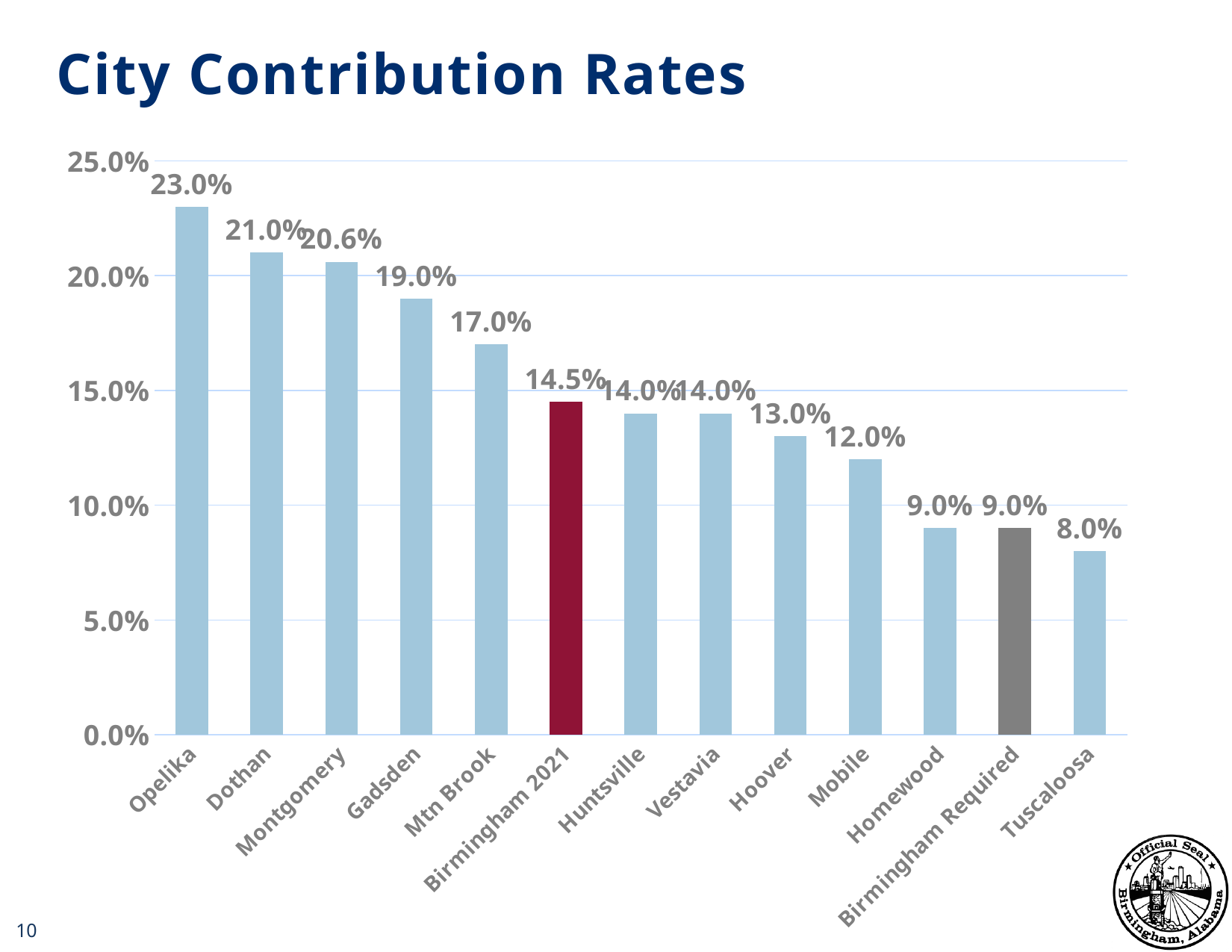
How many cities or categories are shown on the chart? 13 What kind of chart is shown on the slide? Bar chart What is the city contribution rate for Opelika? 23.0% What is the city contribution rate for Birmingham 2021? 14.5% Which city has the lowest contribution rate? Tuscaloosa Do the contribution rates rise or fall from left to right across the chart? Fall Which has a higher contribution rate, Gadsden or Mtn Brook? Gadsden Which city has the highest contribution rate? Opelika What is the difference between the Birmingham 2021 rate and the Birmingham Required rate? 5.5% What is the city contribution rate for Montgomery? 20.6% What is the difference between the contribution rates of Opelika and Tuscaloosa? 15.0% What is the city contribution rate for Birmingham Required? 9.0%